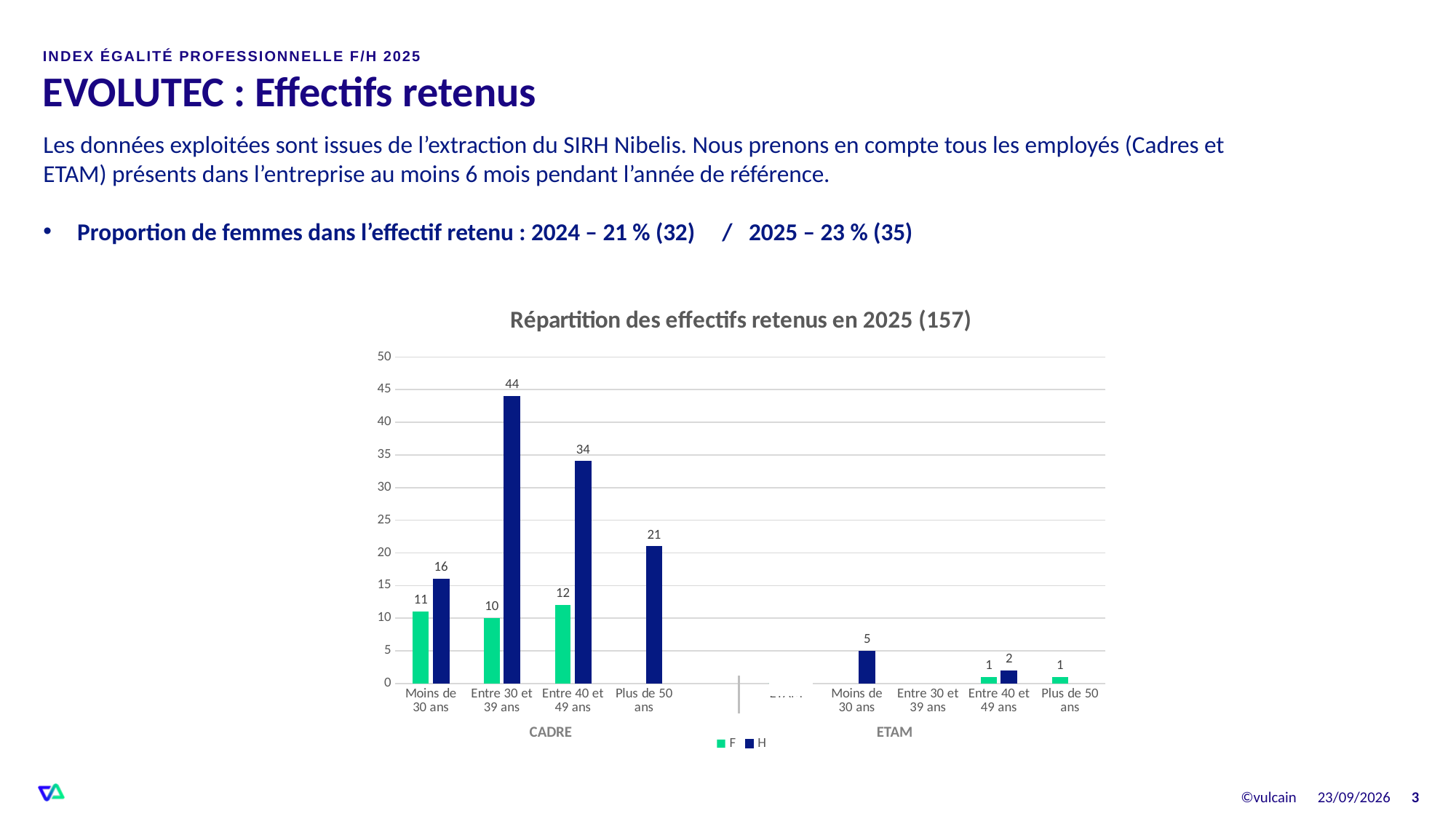
Which is larger for CADRE 'Entre 40 et 49 ans': the F value or the H value? H What type of chart is shown on the slide? bar chart What is the difference between the H values for CADRE 'Entre 30 et 39 ans' and CADRE 'Entre 40 et 49 ans'? 10 What is the value of H for CADRE 'Plus de 50 ans'? 21 What is the difference between the H and F values for CADRE 'Moins de 30 ans'? 5 What is the value of H for CADRE 'Entre 30 et 39 ans'? 44 Is the H value for CADRE 'Entre 40 et 49 ans' greater or less than 30? greater What is the value of H for ETAM 'Moins de 30 ans'? 5 How many series does the chart legend list? 2 What is the value of F for CADRE 'Entre 40 et 49 ans'? 12 Which category has the highest H value? CADRE Entre 30 et 39 ans What is the title of the chart? Répartition des effectifs retenus en 2025 (157)